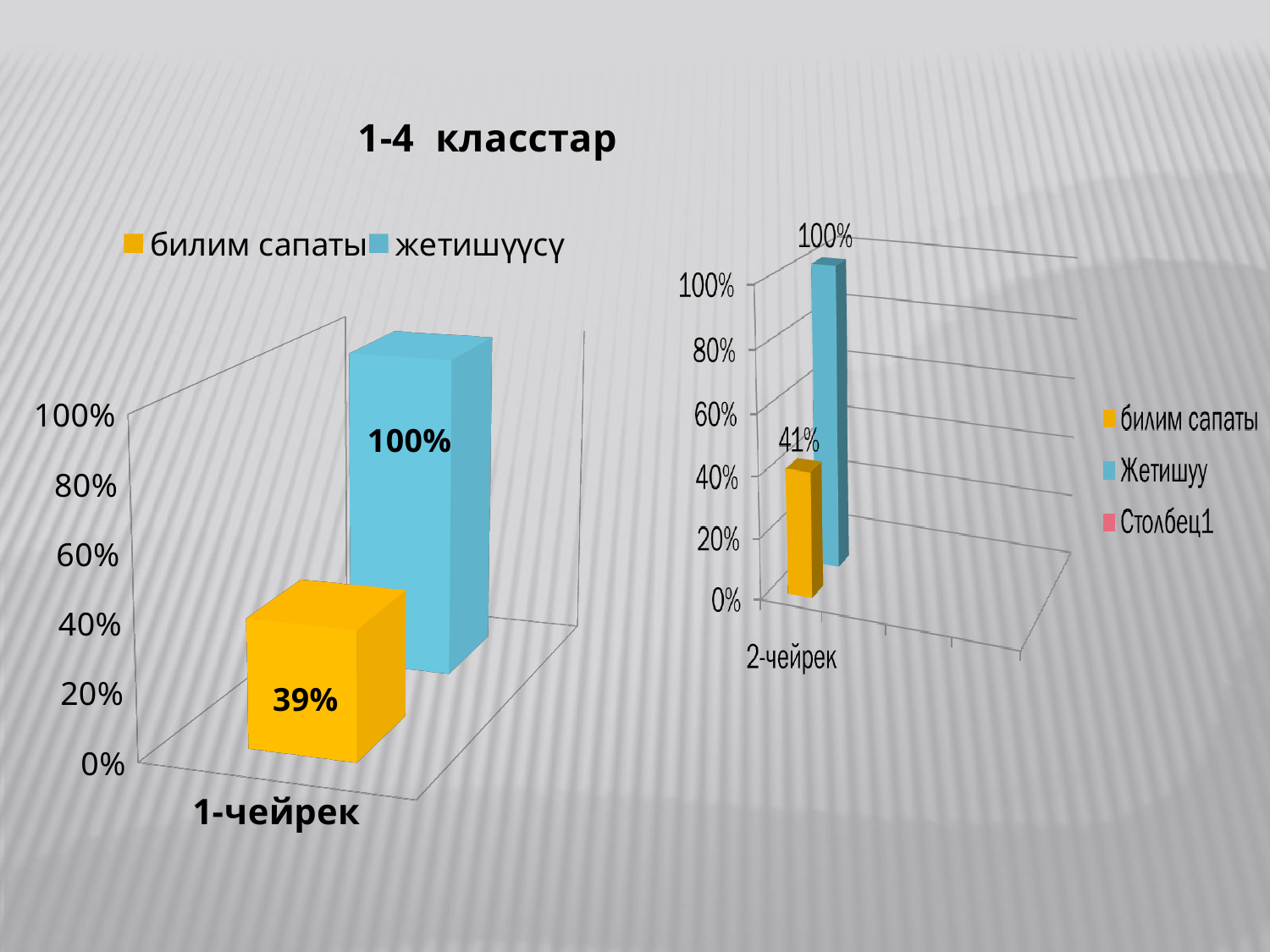
In the left chart (1-чейрек), what is the difference between жетишүүсү and билим сапаты? 61% What kind of chart is the left chart (1-чейрек)? bar chart In the right chart (2-чейрек), what is the difference between Жетишуу and билим сапаты? 59% In the right chart (2-чейрек), what is the value for билим сапаты? 41% In the right chart (2-чейрек), which series has the lowest plotted value? билим сапаты In the right chart (2-чейрек), what is the value for Жетишуу? 100% How many series does the legend of the right chart (2-чейрек) list? 3 In the left chart (1-чейрек), which series has the higher value? жетишүүсү How many series does the legend of the left chart (1-чейрек) list? 2 Is the value for билим сапаты in the left chart (1-чейрек) greater or less than 40%? less In the left chart (1-чейрек), what is the value for билим сапаты? 39% In the left chart (1-чейрек), what is the value for жетишүүсү? 100%